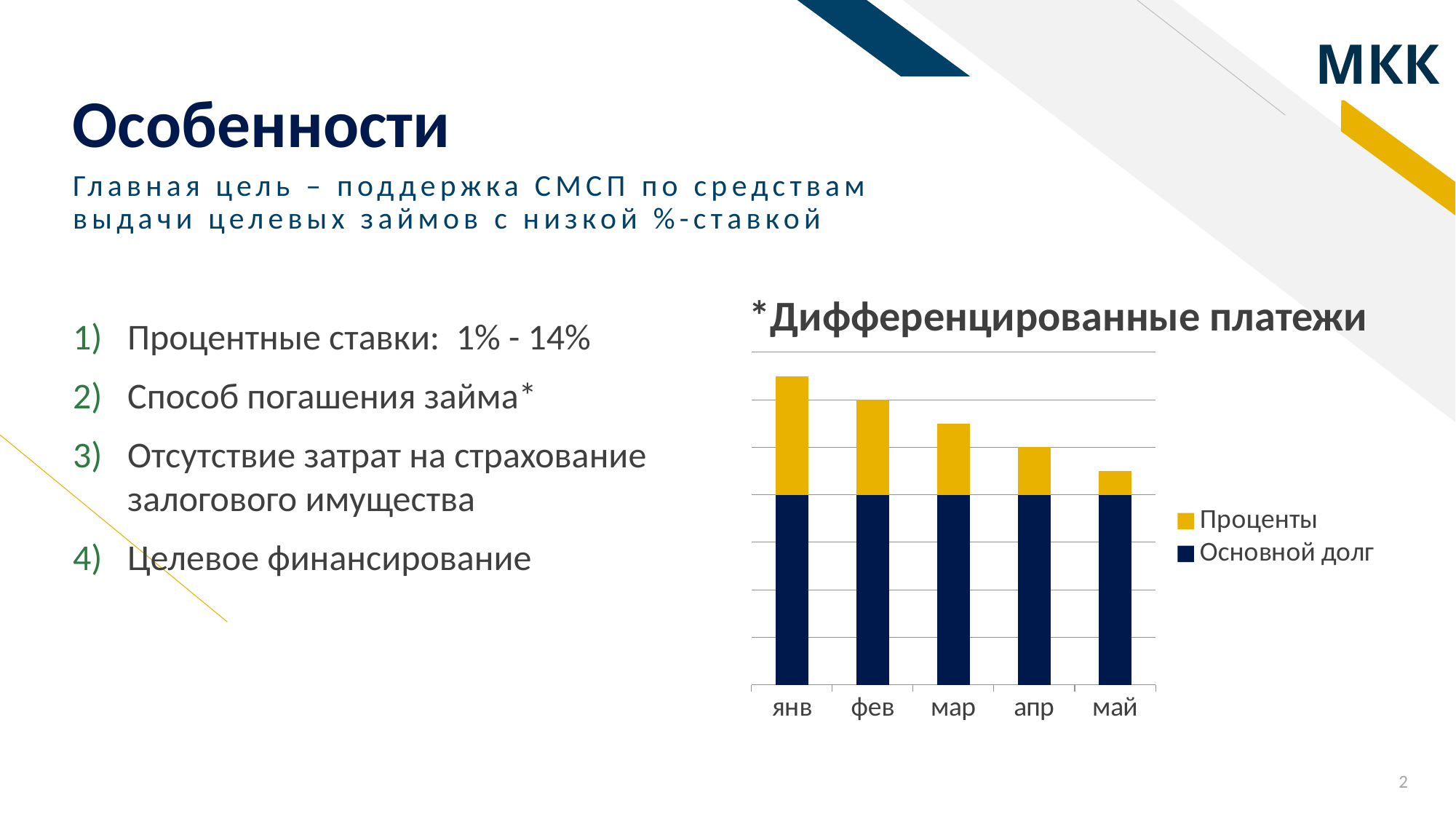
What are the two series listed in the chart legend? Проценты and Основной долг What is the title of the chart? *Дифференцированные платежи Which month has the tallest total bar? янв Is the total bar for фев larger or smaller than the total bar for апр? Larger Do the total bar heights rise or fall from янв to май? Fall Which month has the highest Проценты segment? янв What kind of chart is shown on the slide? Stacked bar chart How many months are shown on the x axis of the chart? 5 Which month has the lowest Проценты segment? май Which month has the shortest total bar? май How many series does the chart legend list? 2 Is the Проценты segment larger in янв or in май? янв